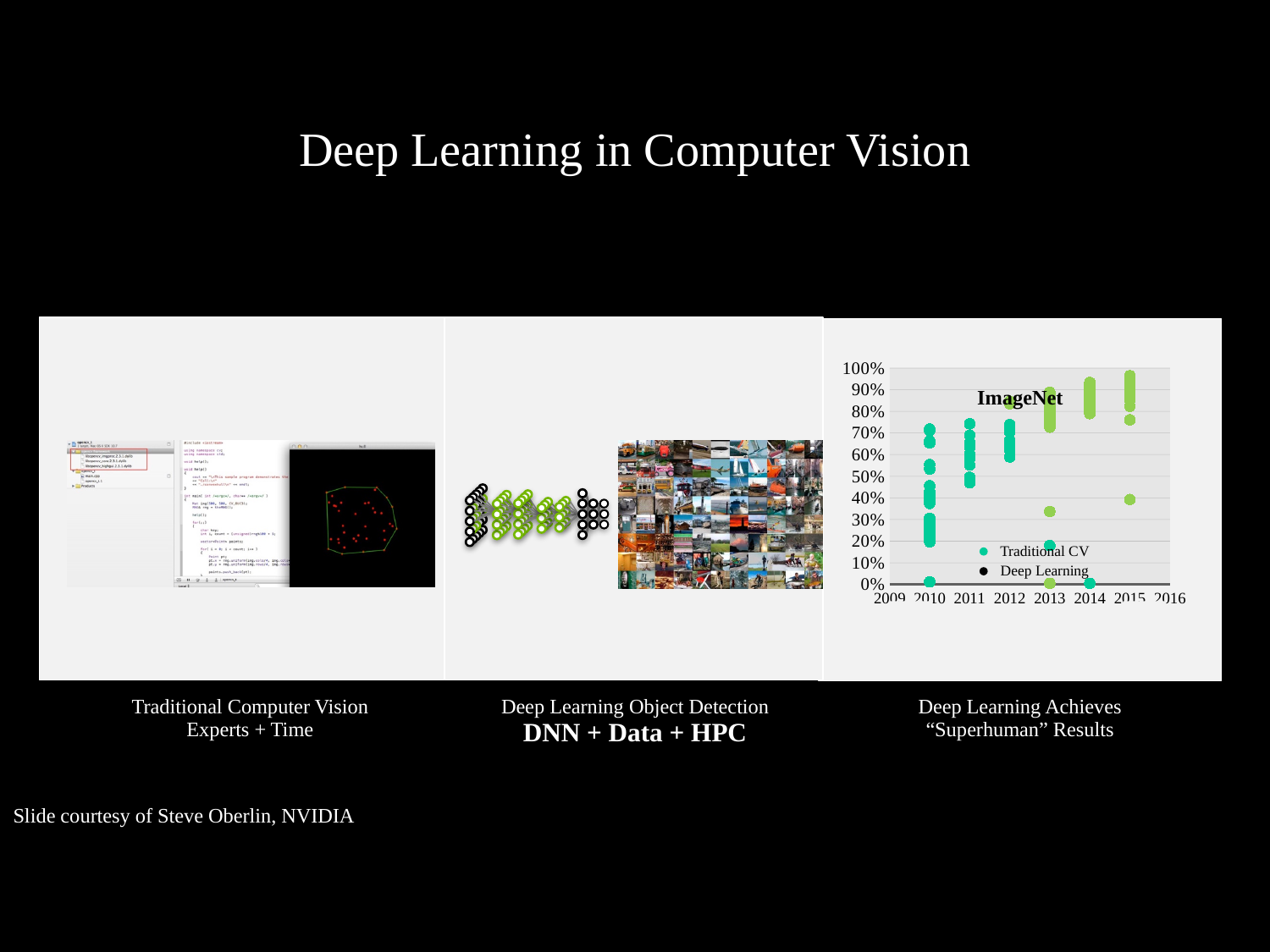
How many series does the legend of the ImageNet chart list? 2 How many year labels are shown on the x axis of the ImageNet chart? 8 In the ImageNet chart, is the highest point plotted for 2014 greater or less than 80%? greater What is the title shown inside the chart on the right? ImageNet In the ImageNet chart, is the highest point plotted for 2010 greater or less than 80%? less What kind of chart is shown on the right side of the slide? scatter chart In the ImageNet chart, do the highest plotted values rise or fall from 2010 to 2015? rise In the ImageNet chart, is the highest point plotted for 2015 greater or less than 90%? greater In the ImageNet chart, which year has the highest plotted point, 2010 or 2015? 2015 What is the highest value shown on the y axis of the ImageNet chart? 100% What are the two series named in the legend of the ImageNet chart? Traditional CV and Deep Learning